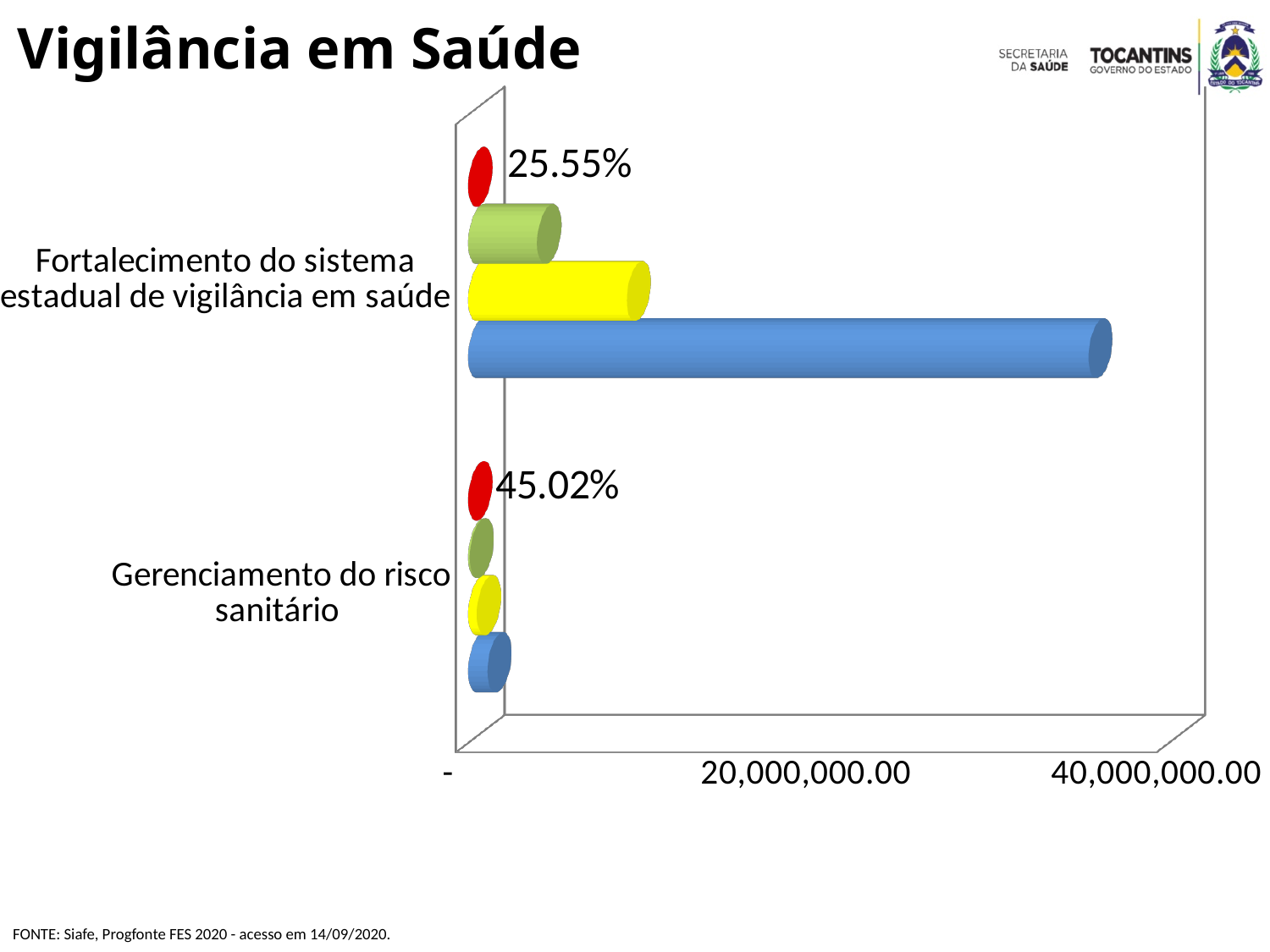
What is the difference between the percentage labels of 'Gerenciamento do risco sanitário' and 'Fortalecimento do sistema estadual de vigilância em saúde'? 19.47% Which category has the larger percentage label, 'Fortalecimento do sistema estadual de vigilância em saúde' or 'Gerenciamento do risco sanitário'? Gerenciamento do risco sanitário How many categories are shown on the chart's vertical axis? 2 What is the title of the slide containing the chart? Vigilância em Saúde What percentage label is shown for 'Fortalecimento do sistema estadual de vigilância em saúde'? 25.55% Is the value of the blue bar for 'Fortalecimento do sistema estadual de vigilância em saúde' greater or less than 20,000,000.00? greater What percentage label is shown for 'Gerenciamento do risco sanitário'? 45.02% Is the value of the blue bar for 'Gerenciamento do risco sanitário' greater or less than 20,000,000.00? less What kind of chart is shown on the slide? bar chart Is the value of the yellow bar for 'Fortalecimento do sistema estadual de vigilância em saúde' greater or less than 20,000,000.00? less What is the highest value shown on the chart's horizontal axis? 40,000,000.00 Which category has the longest bar on the chart? Fortalecimento do sistema estadual de vigilância em saúde